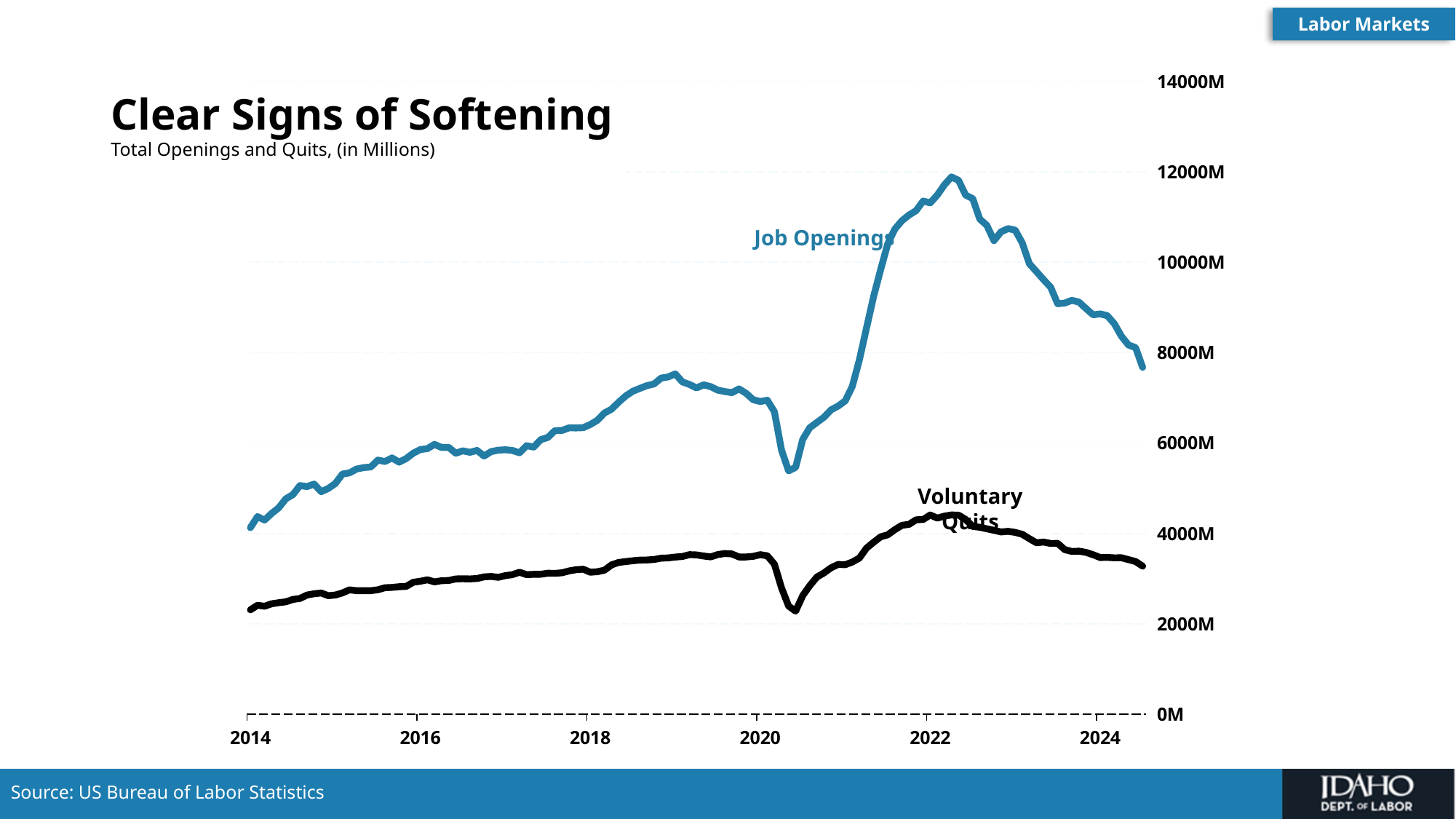
What kind of chart is shown on the slide? line chart Do Job Openings rise or fall between 2022 and 2024? fall Is the value of Voluntary Quits at the start of the series in 2014 greater or less than 2000M? greater Which series is higher in 2022, Job Openings or Voluntary Quits? Job Openings Is the value of Job Openings at the end of the series in 2024 greater or less than 8000M? less Is the value of Job Openings in 2014 greater or less than 6000M? less Which series reaches the highest value on the chart? Job Openings What are the names of the two series plotted on the chart? Job Openings and Voluntary Quits What is the title of the chart? Clear Signs of Softening How many series are plotted on the chart? 2